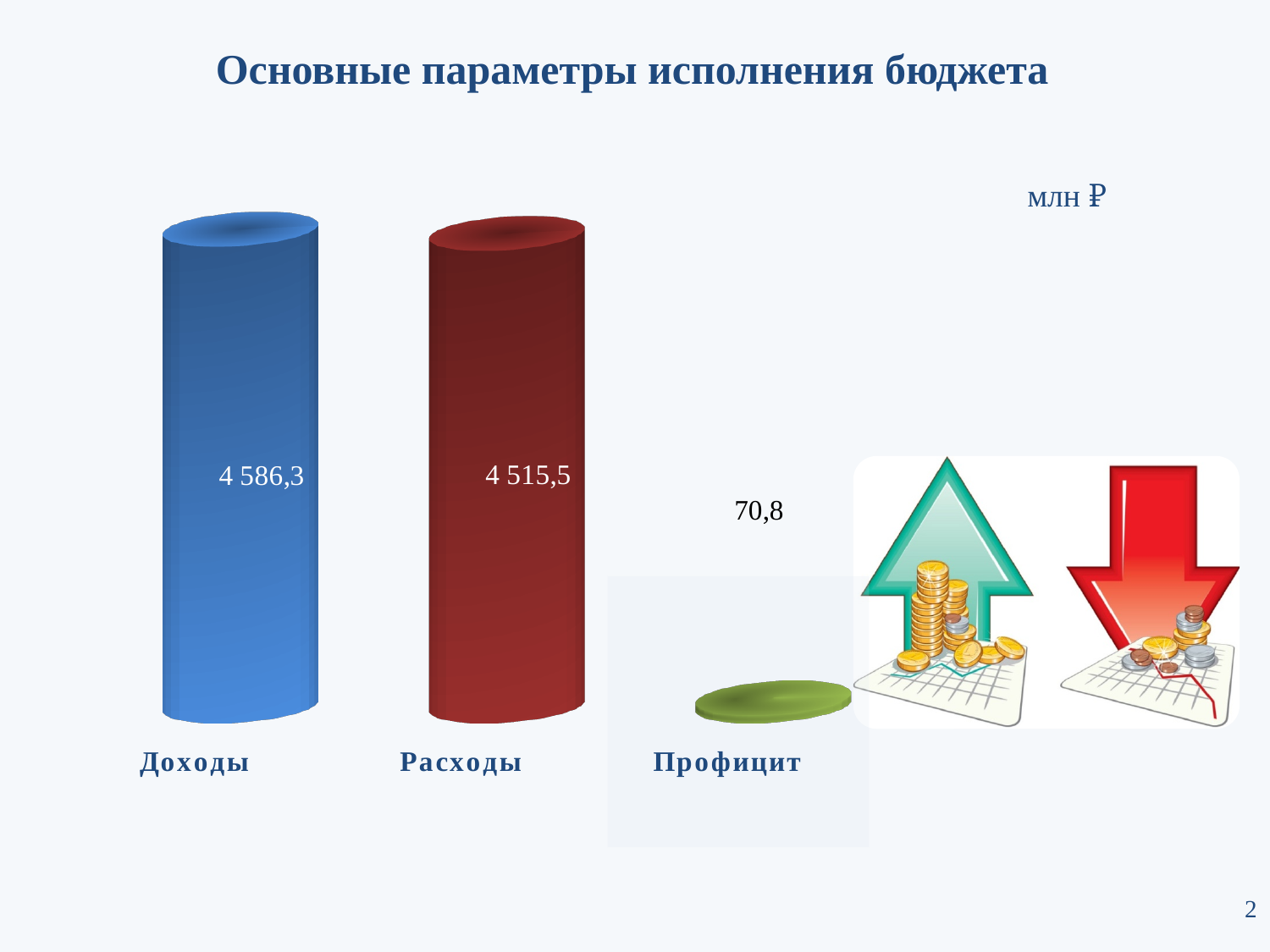
What unit is indicated for the values in the chart? млн ₽ What is the value for Профицит? 70,8 How many categories are shown in the chart? 3 Which category has the highest value? Доходы What is the difference between the values for Доходы and Расходы? 70,8 What is the value for Расходы? 4 515,5 What kind of chart is shown on the slide? Bar chart What is the title of the slide? Основные параметры исполнения бюджета Which is larger, the value for Расходы or the value for Профицит? Расходы Which is larger, the value for Доходы or the value for Расходы? Доходы Which category has the lowest value? Профицит What is the value for Доходы? 4 586,3